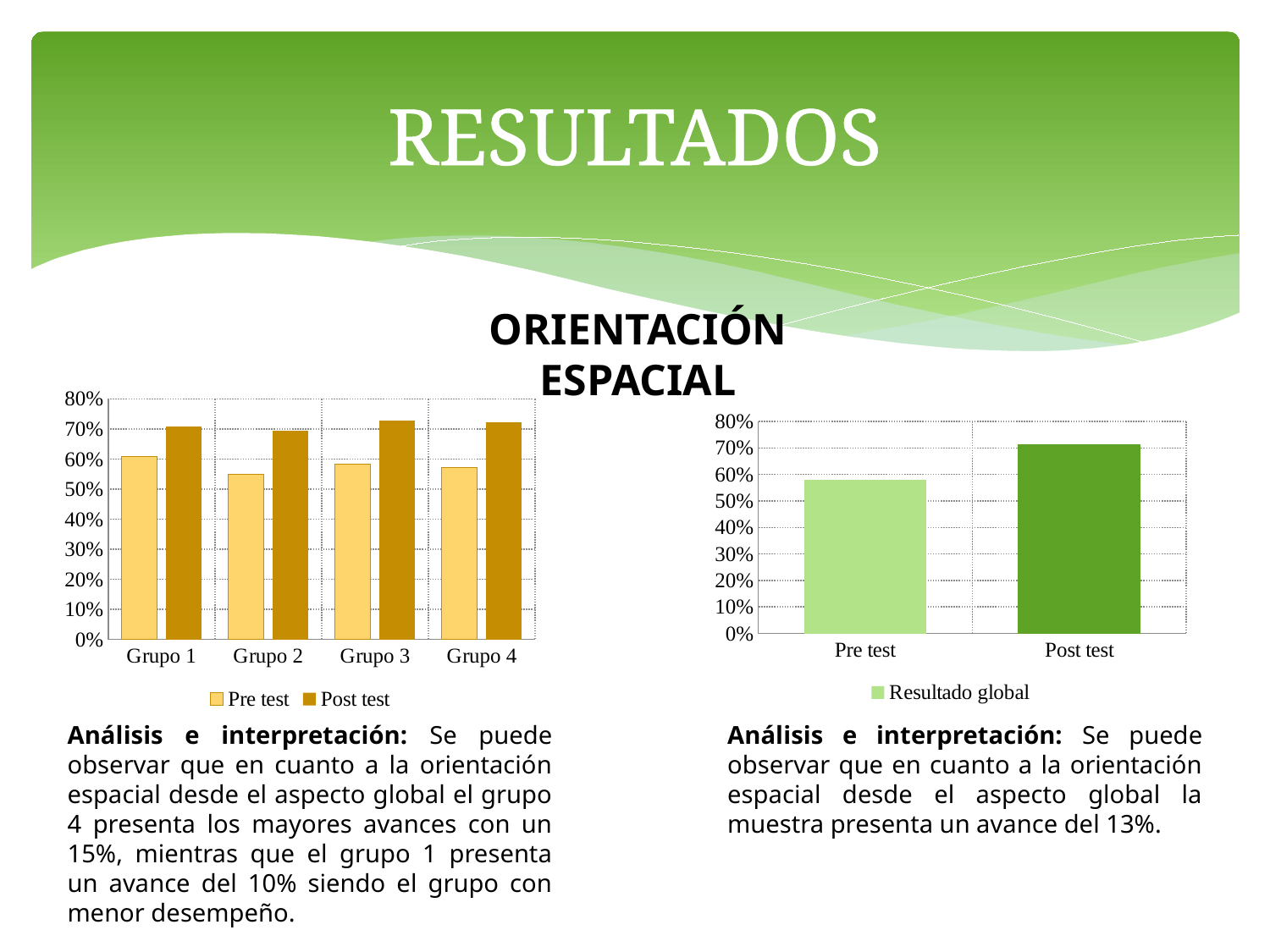
In the left chart, which group has the highest Pre test value? Grupo 1 In the right chart, which bar is higher: Pre test or Post test? Post test How many series does the legend of the left chart list? 2 In the left chart, is the Pre test value for Grupo 4 greater or less than 60%? less What kind of chart is the left chart on the slide? Bar chart In the right chart, is the Pre test value greater or less than 60%? less In the left chart, which is larger for Grupo 2: the Pre test value or the Post test value? Post test In the left chart, is the Post test value for Grupo 3 greater or less than 70%? greater How many groups (categories) are shown on the x axis of the left chart? 4 What is the legend entry shown below the right chart? Resultado global How many bars are plotted in the right chart? 2